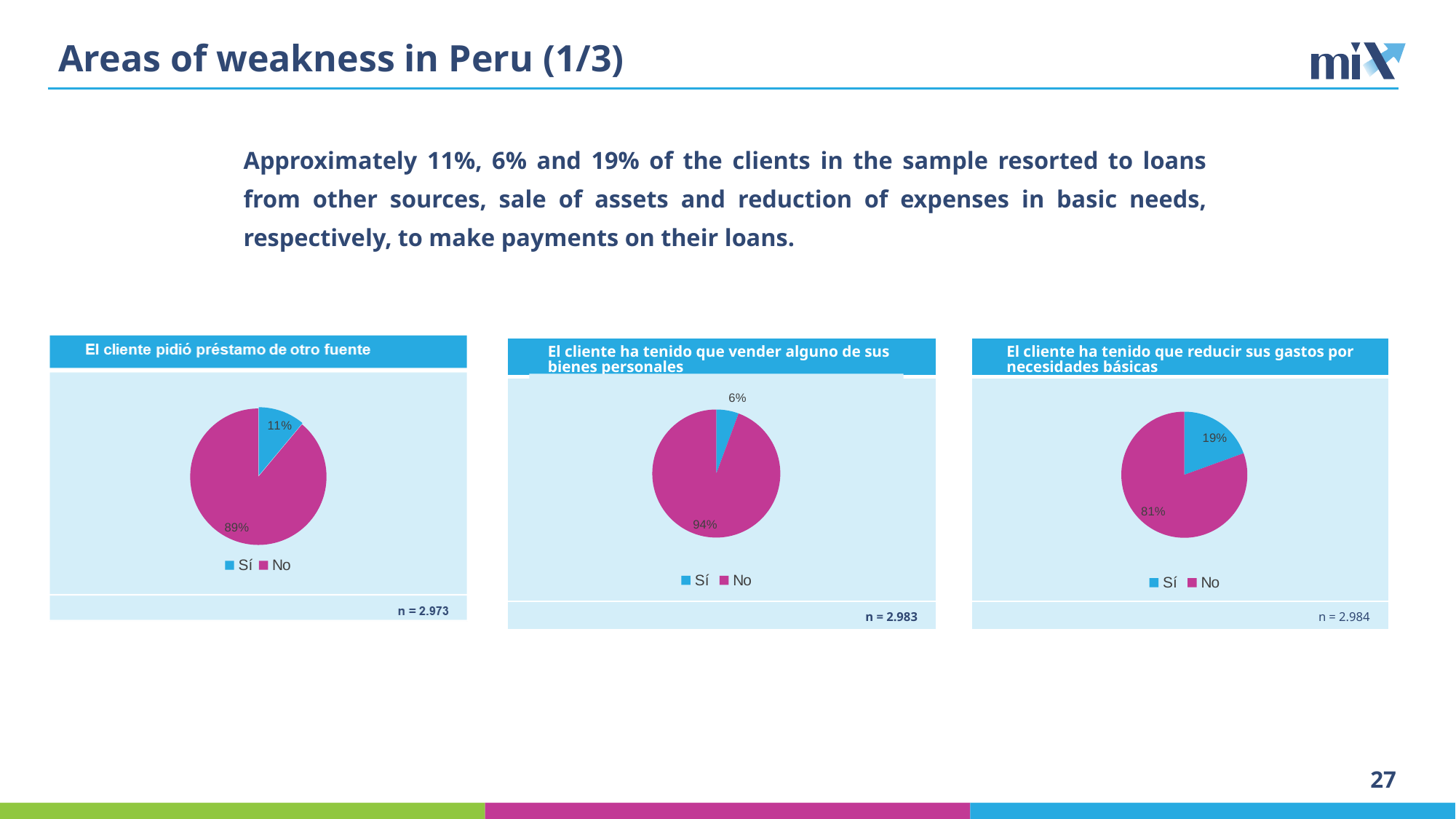
How many entries does the legend of the right pie chart list? 2 In the left pie chart titled 'El cliente pidió préstamo de otro fuente', what percentage is shown for 'No'? 89% In the middle pie chart about selling personal belongings, what percentage is shown for 'Sí'? 6% What sample size (n) is shown below the middle pie chart? n = 2.983 What type of chart is used in the middle panel of the slide? Pie chart In the right pie chart about reducing spending on basic needs, what percentage is shown for 'No'? 81% In the left pie chart titled 'El cliente pidió préstamo de otro fuente', what percentage is shown for 'Sí'? 11% How many slices does the left pie chart have? 2 In the right pie chart, what is the difference between the 'No' and 'Sí' percentages? 62% In the left pie chart, which slice is larger, 'Sí' or 'No'? No In the middle pie chart about selling personal belongings, what percentage is shown for 'No'? 94% In the right pie chart about reducing spending on basic needs, what percentage is shown for 'Sí'? 19%